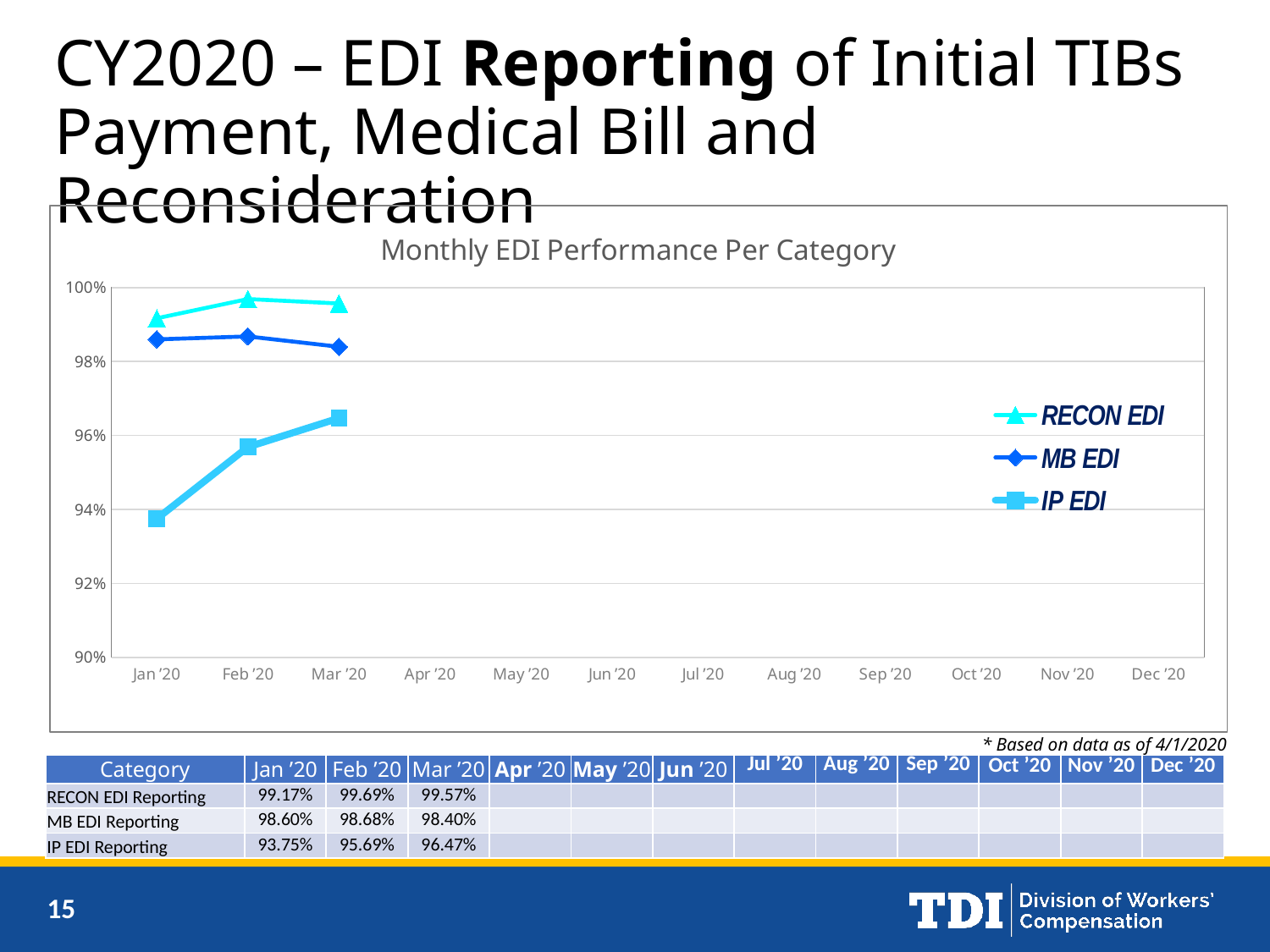
What is the MB EDI value for Mar '20? 98.40% Is the IP EDI value for Jan '20 greater or less than 94%? less What is the title of the chart? Monthly EDI Performance Per Category What is the RECON EDI value for Feb '20? 99.69% How many series does the chart legend list? 3 What is the IP EDI value for Jan '20? 93.75% What is the difference between the IP EDI values for Mar '20 and Jan '20? 2.72% Does the IP EDI series rise or fall from Jan '20 to Mar '20? rise What kind of chart is shown on the slide? line chart Which is larger, the MB EDI value for Feb '20 or the MB EDI value for Mar '20? Feb '20 Which series has the highest value in Mar '20? RECON EDI Which series has the lowest value in Jan '20? IP EDI